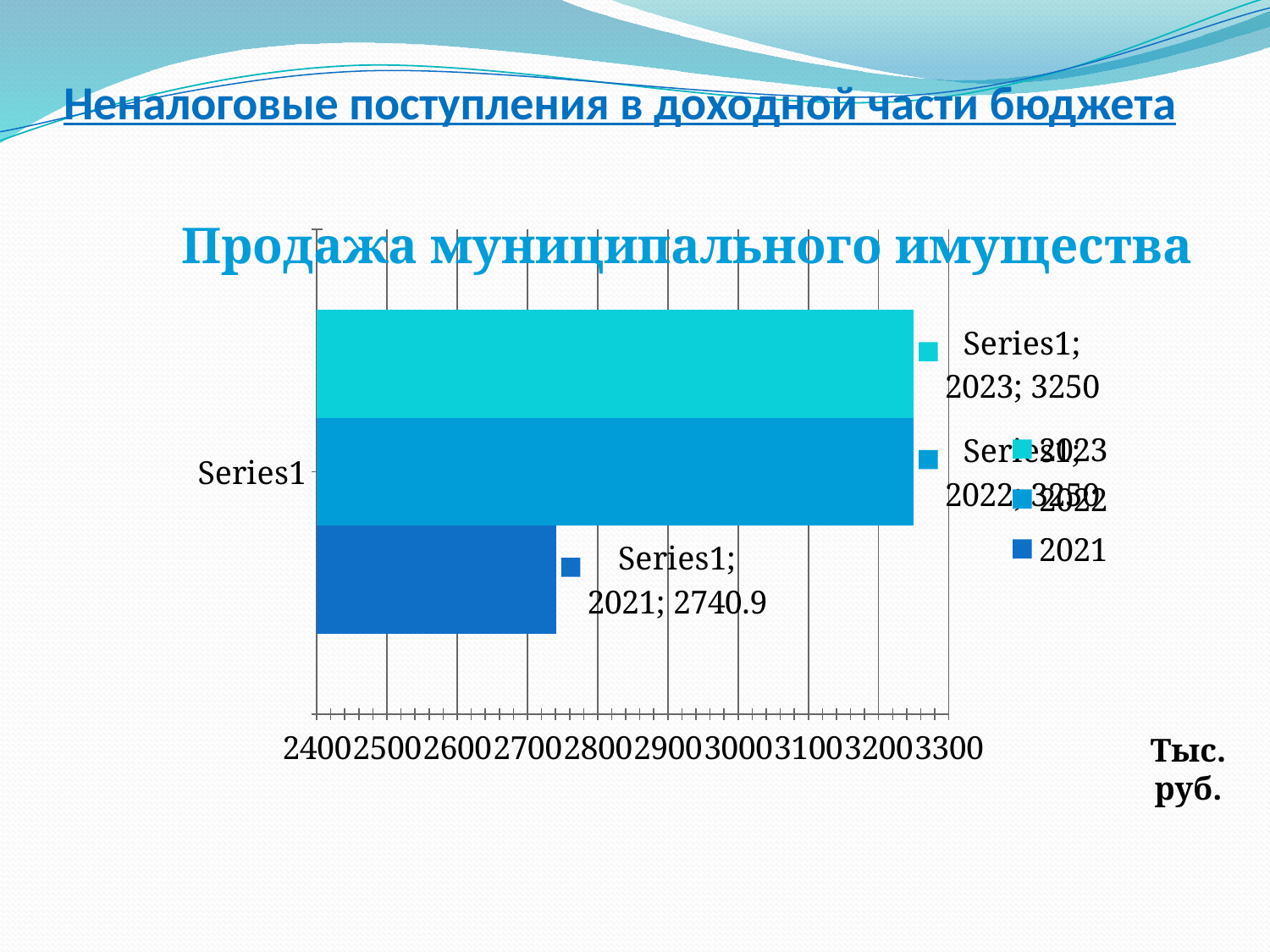
What is the difference between the values for 2023 and 2021 in the chart 'Продажа муниципального имущества'? 509.1 Is the value for 2023 in the chart 'Продажа муниципального имущества' greater or less than 3200? greater Which year has the lowest value in the chart 'Продажа муниципального имущества'? 2021 How many series does the legend of the chart 'Продажа муниципального имущества' list? 3 Is the value for 2021 in the chart 'Продажа муниципального имущества' greater or less than 2700? greater How many bars are plotted in the chart 'Продажа муниципального имущества'? 3 What is the value for 2022 in the chart 'Продажа муниципального имущества'? 3250 What kind of chart is 'Продажа муниципального имущества'? bar chart Which is larger in the chart 'Продажа муниципального имущества', the value for 2022 or the value for 2021? 2022 What is the value for 2021 in the chart 'Продажа муниципального имущества'? 2740.9 What is the value for 2023 in the chart 'Продажа муниципального имущества'? 3250 What unit is shown next to the axis of the chart 'Продажа муниципального имущества'? Тыс. руб.